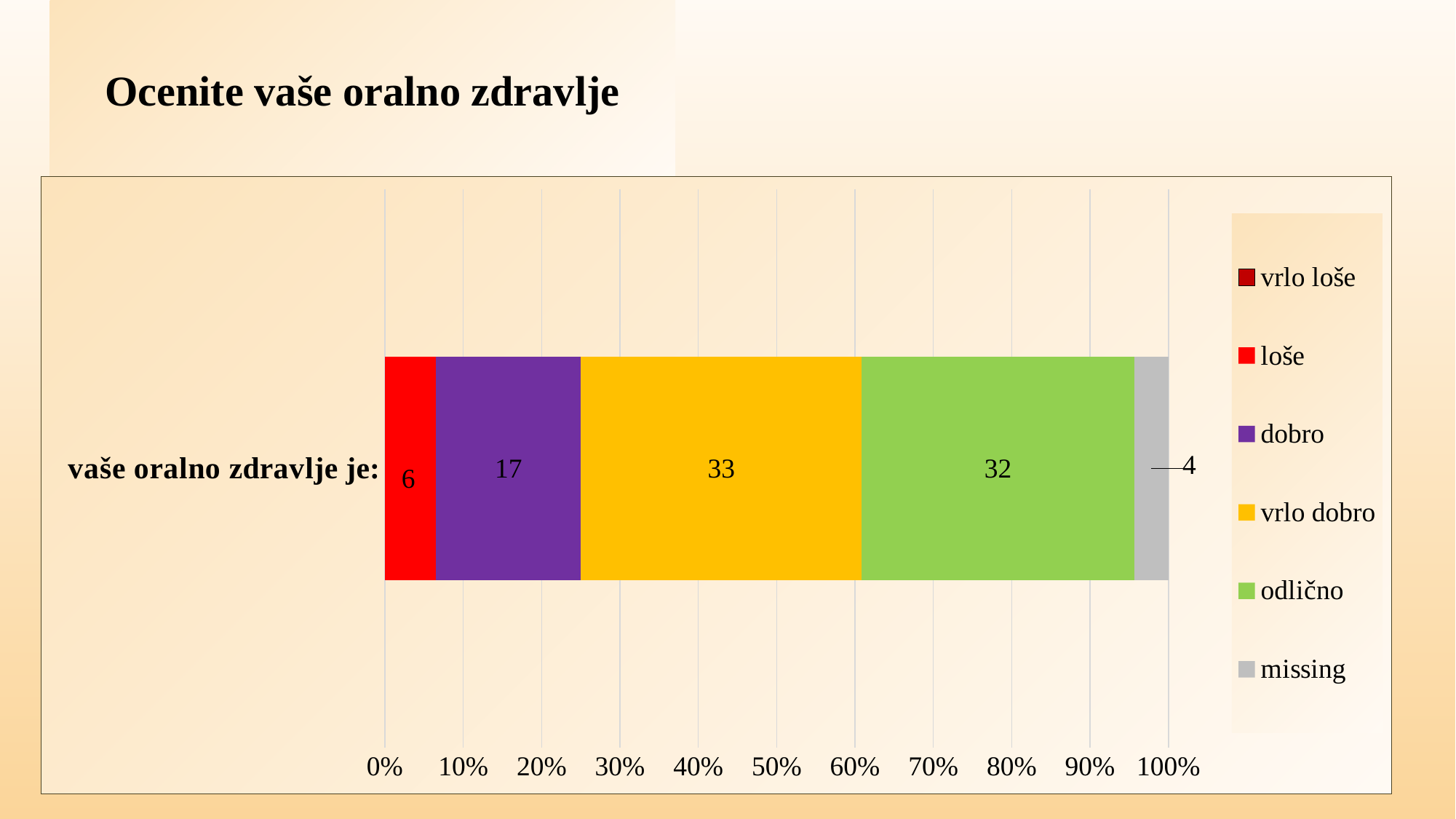
What kind of chart is shown on the slide? stacked bar chart What is the difference between the values for 'vrlo dobro' and 'dobro'? 16 What is the value for 'vrlo dobro' in the bar? 33 What is the value for 'missing' in the bar? 4 What is the value for 'loše' in the bar? 6 What is the value for 'dobro' in the bar? 17 How many series does the legend list? 6 Which is larger, the value for 'dobro' or the value for 'loše'? dobro Which labelled series has the lowest value? missing Which labelled series has the highest value? vrlo dobro What colour represents 'odlično' in the legend? green What is the value for 'odlično' in the bar? 32